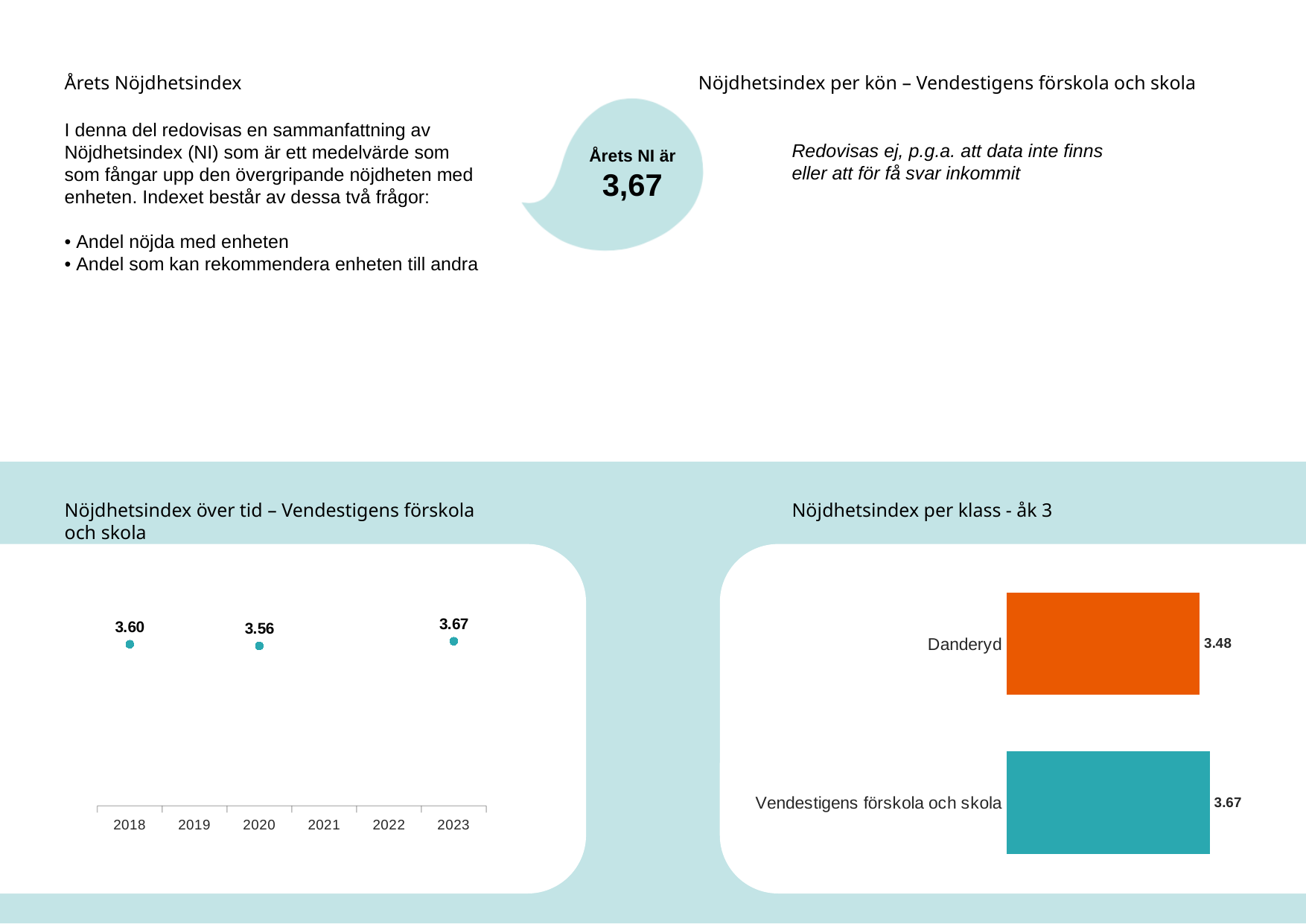
In the chart 'Nöjdhetsindex per klass - åk 3', what is the difference between Vendestigens förskola och skola and Danderyd? 0.19 In the chart 'Nöjdhetsindex över tid – Vendestigens förskola och skola', which year has the highest value? 2023 In the chart 'Nöjdhetsindex över tid – Vendestigens förskola och skola', what is the difference between the 2023 value and the 2020 value? 0.11 In the chart 'Nöjdhetsindex per klass - åk 3', what is the value for Vendestigens förskola och skola? 3.67 In the chart 'Nöjdhetsindex över tid – Vendestigens förskola och skola', how many data points are plotted? 3 In the chart 'Nöjdhetsindex per klass - åk 3', which category has the higher value, Danderyd or Vendestigens förskola och skola? Vendestigens förskola och skola In the chart 'Nöjdhetsindex över tid – Vendestigens förskola och skola', what is the value for 2020? 3.56 In the chart 'Nöjdhetsindex över tid – Vendestigens förskola och skola', which year has the lowest value? 2020 In the chart 'Nöjdhetsindex över tid – Vendestigens förskola och skola', what is the value for 2018? 3.60 In the chart 'Nöjdhetsindex över tid – Vendestigens förskola och skola', what is the value for 2023? 3.67 What kind of chart is 'Nöjdhetsindex per klass - åk 3'? Bar chart In the chart 'Nöjdhetsindex per klass - åk 3', what is the value for Danderyd? 3.48